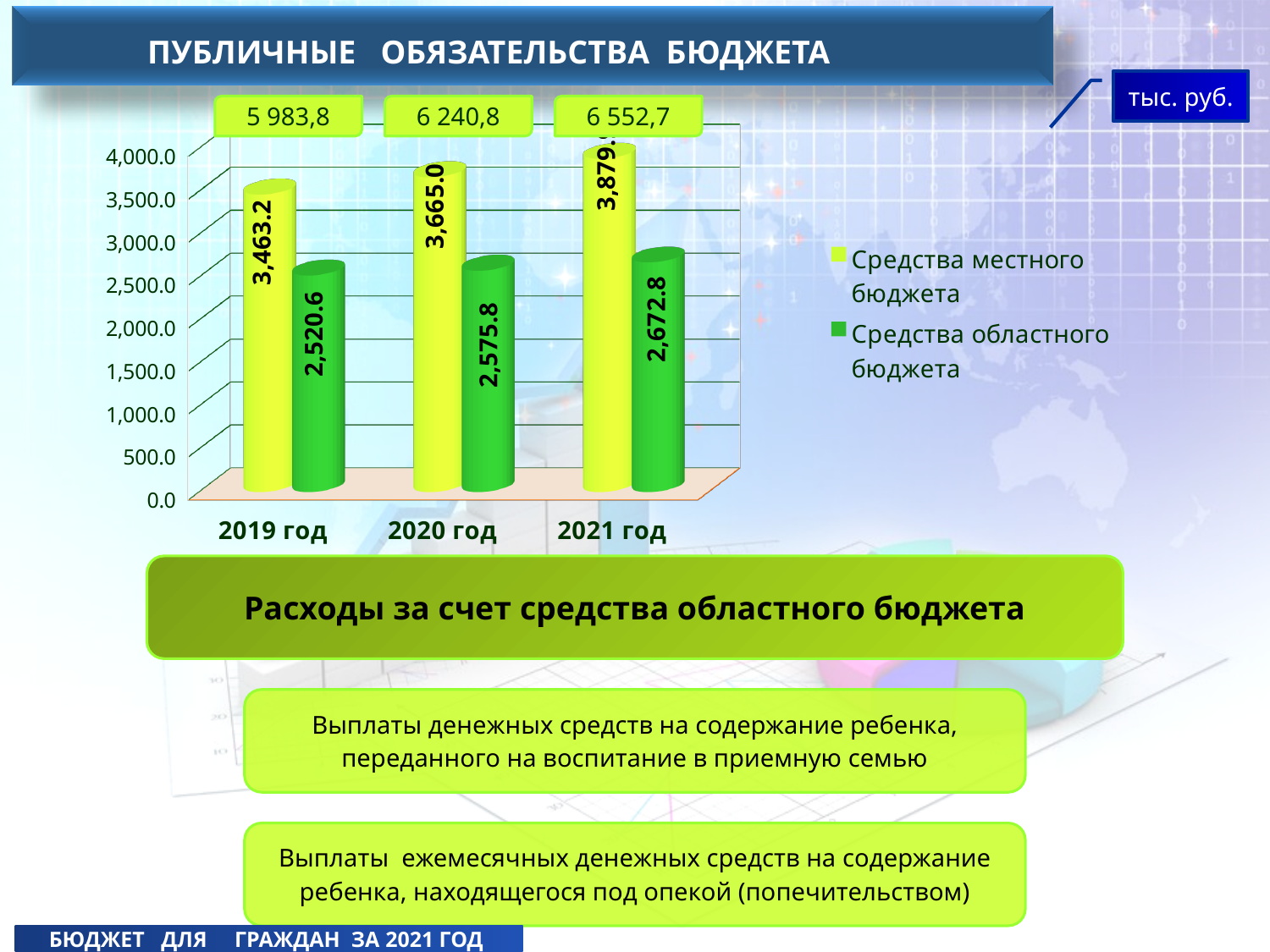
What is the value for Средства областного бюджета in 2020 год? 2,575.8 Is the value for Средства местного бюджета in 2021 год greater or less than 3,500.0? greater Which year has the lowest value for Средства областного бюджета? 2019 год What is the difference between Средства местного бюджета and Средства областного бюджета in 2019 год? 942.6 What is the value for Средства местного бюджета in 2019 год? 3,463.2 What is the value for Средства областного бюджета in 2021 год? 2,672.8 Do the values for Средства областного бюджета rise or fall from 2019 год to 2021 год? rise How many series does the chart legend list? 2 What total is printed above the bars for 2021 год? 6 552,7 What kind of chart is shown on the slide? bar chart What is the value for Средства местного бюджета in 2020 год? 3,665.0 How many years (categories) are shown on the x axis of the chart? 3